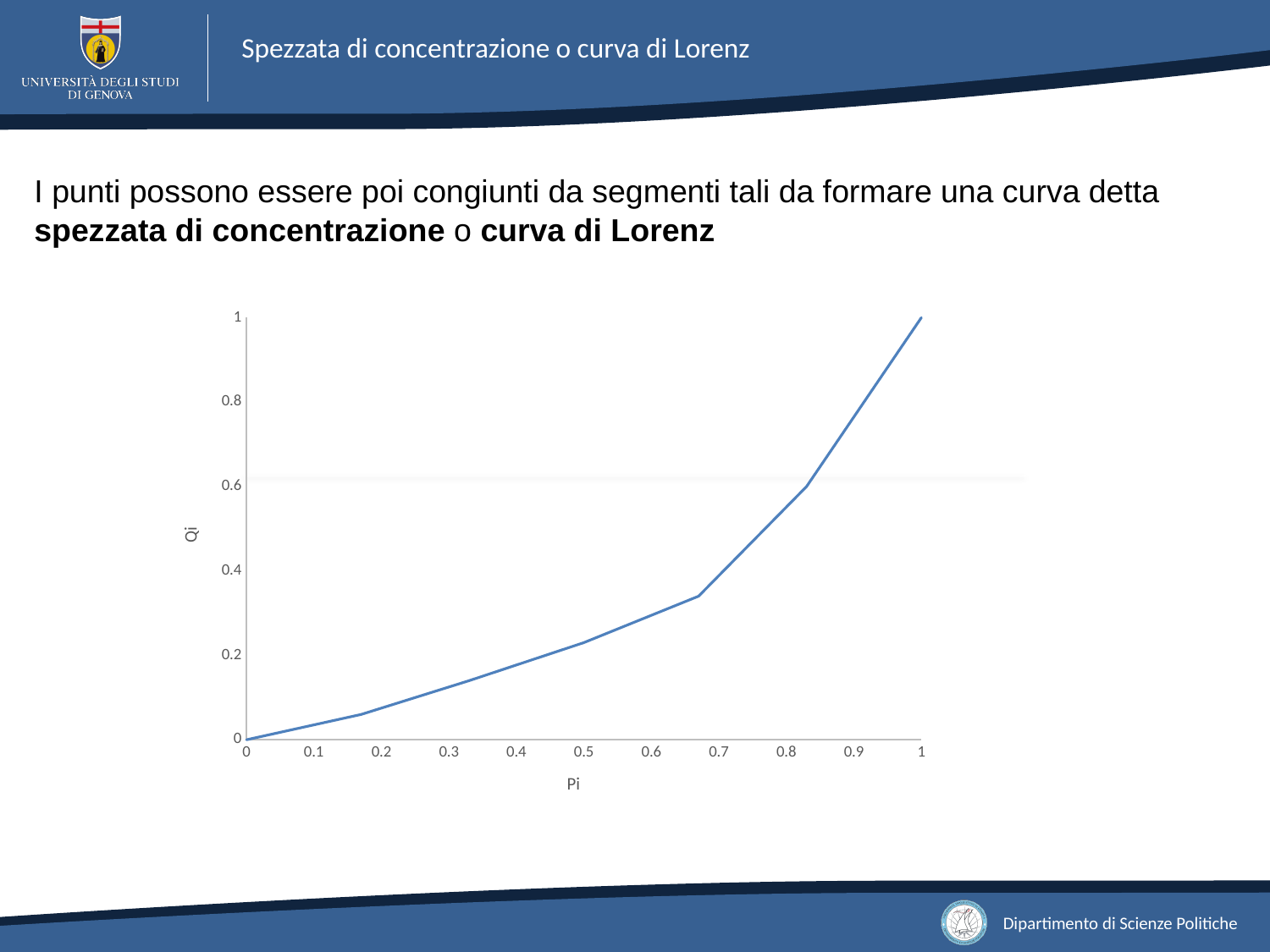
At which value of Pi is Qi lowest? 0 What is the label of the x axis of the chart? Pi Is the value of Qi at Pi = 0.5 greater or less than 0.4? less At which value of Pi is Qi highest? 1 Is the value of Qi at Pi = 0.9 greater or less than 0.6? greater Is the value of Qi at Pi = 0.7 greater or less than 0.6? less What is the label of the y axis of the chart? Qi What is the value of Qi at Pi = 1? 1 What kind of chart is shown on the slide? line chart What is the value of Qi at Pi = 0? 0 Do the values of Qi rise or fall as Pi increases along the x axis? rise Which is larger, the value of Qi at Pi = 0.3 or at Pi = 0.8? Pi = 0.8